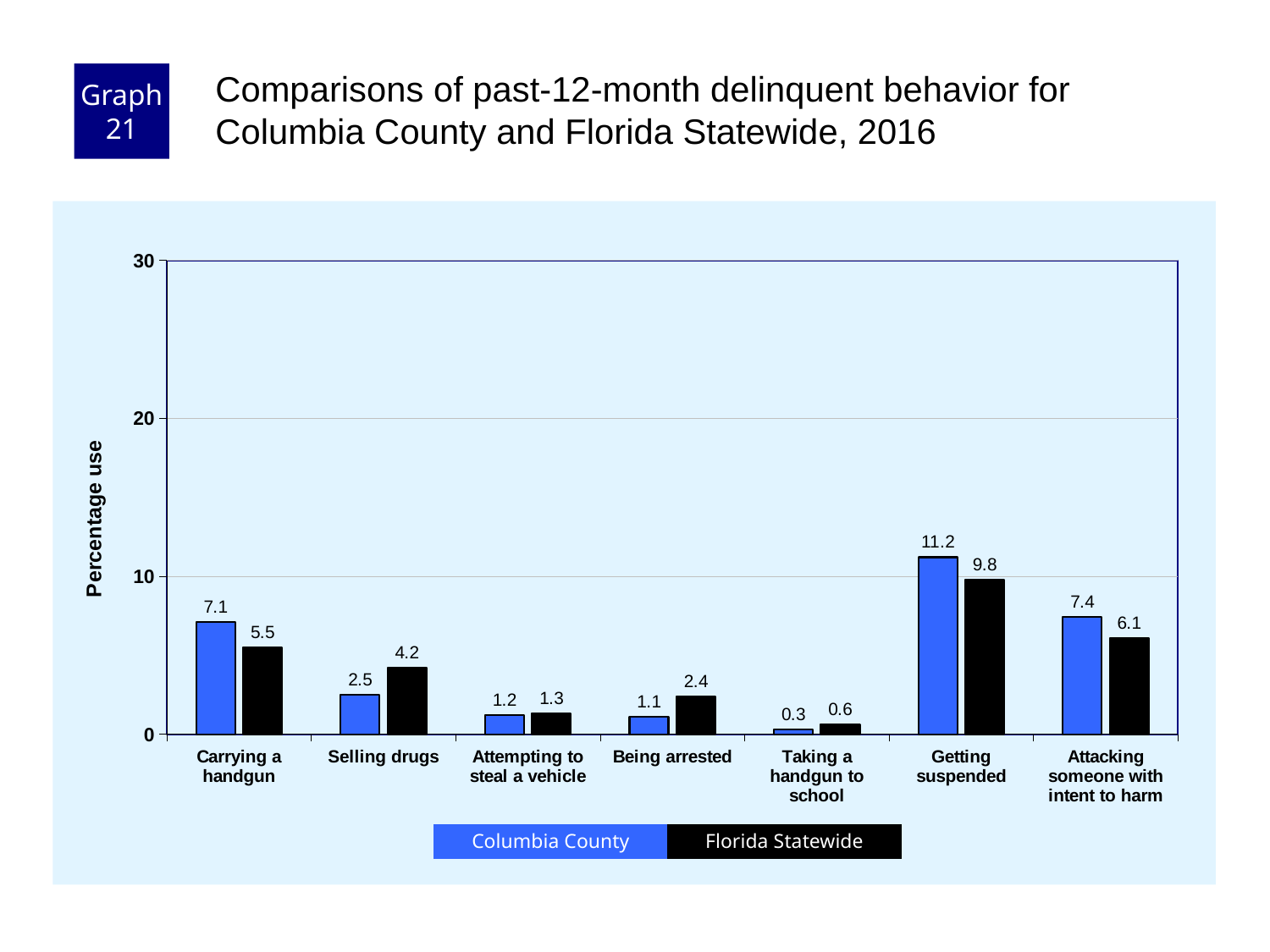
What is the Columbia County value for Taking a handgun to school? 0.3 How many categories are shown on the x axis? 7 Is the Columbia County value for Getting suspended greater or less than 10? greater Which category has the lowest Columbia County value? Taking a handgun to school Which is larger for Being arrested: Columbia County or Florida Statewide? Florida Statewide What is the Columbia County value for Getting suspended? 11.2 What kind of chart is shown on the slide? bar chart Which category has the highest Florida Statewide value? Getting suspended What is the label of the y axis? Percentage use How many series does the legend list? 2 What is the difference between the Columbia County and Florida Statewide values for Carrying a handgun? 1.6 What is the Florida Statewide value for Selling drugs? 4.2